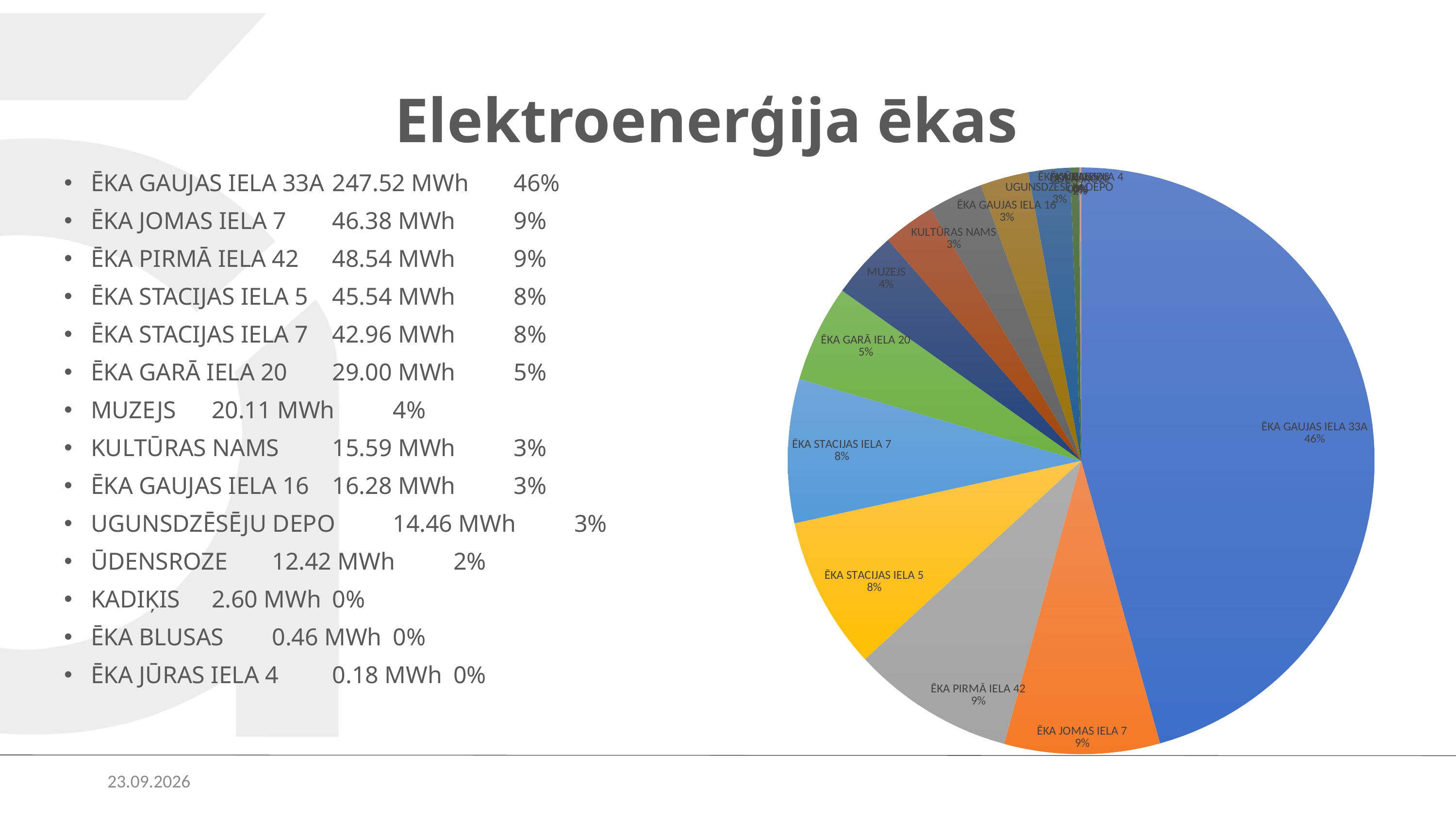
What is the difference in percentage points between the ĒKA GAUJAS IELA 33A slice and the ĒKA JOMAS IELA 7 slice? 37 What share of the pie does ĒKA PIRMĀ IELA 42 have? 9% What share of the pie does ĒKA GAUJAS IELA 33A have? 46% What share of the pie does MUZEJS have? 4% What kind of chart is shown on the slide? pie chart What is the title of the slide containing the pie chart? Elektroenerģija ēkas Which slice is larger, ĒKA GAUJAS IELA 33A or ĒKA JOMAS IELA 7? ĒKA GAUJAS IELA 33A Which slice is larger, ĒKA STACIJAS IELA 5 or MUZEJS? ĒKA STACIJAS IELA 5 Which slice of the pie chart is the largest? ĒKA GAUJAS IELA 33A